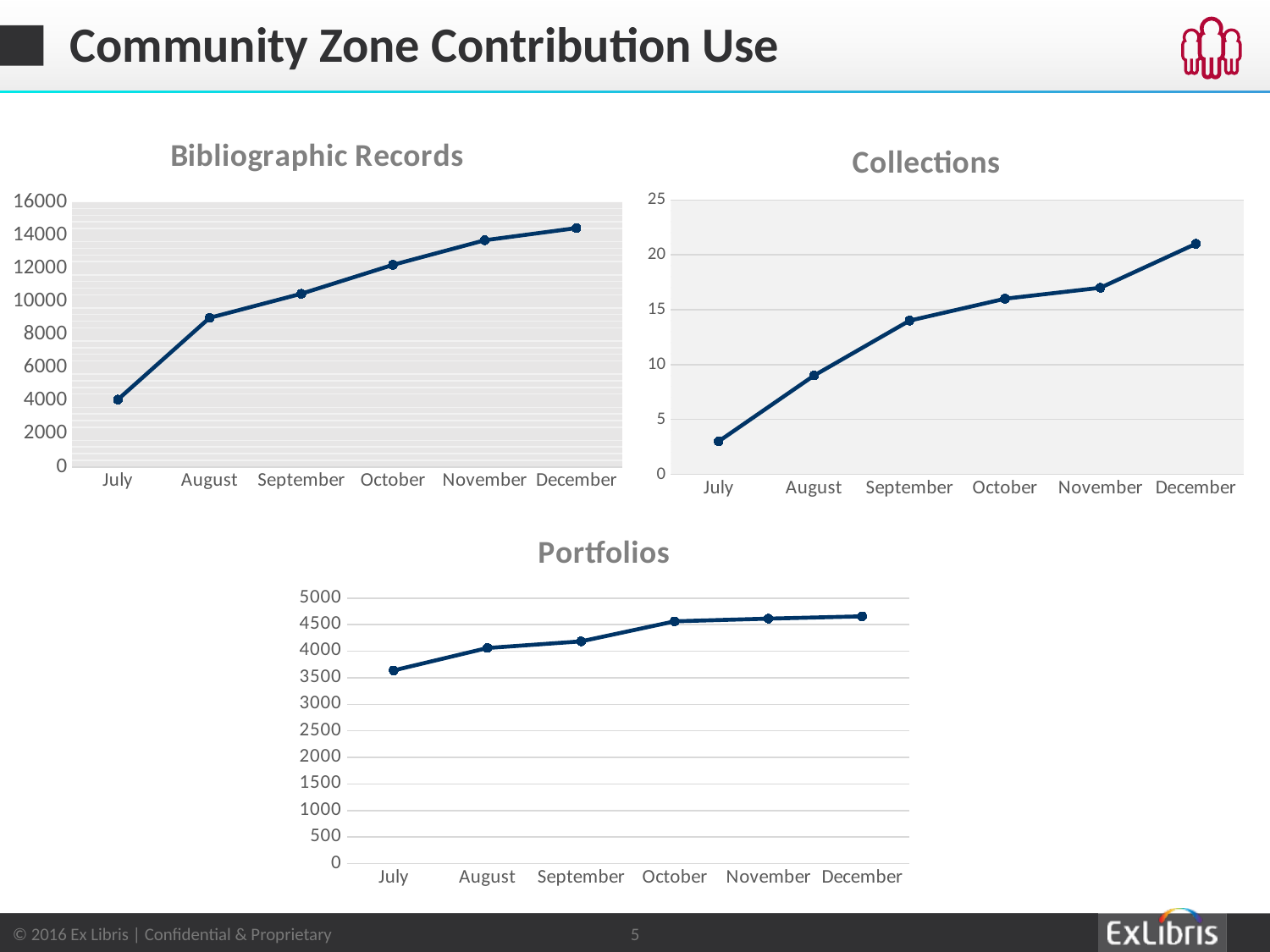
In the Collections chart, is the value for December greater or less than 20? greater How many months are plotted in the Portfolios chart? 6 In the Portfolios chart, is the value for July greater or less than 3500? greater In the Bibliographic Records chart, which month has the highest value? December In the Collections chart, do the values rise or fall from July to December? rise In the Portfolios chart, which is larger, the value for August or the value for October? October In the Bibliographic Records chart, is the value for October greater or less than 10000? greater In the Collections chart, which month has the lowest value? July In the Bibliographic Records chart, which month has the lowest value? July What kind of chart is the Bibliographic Records chart? line chart